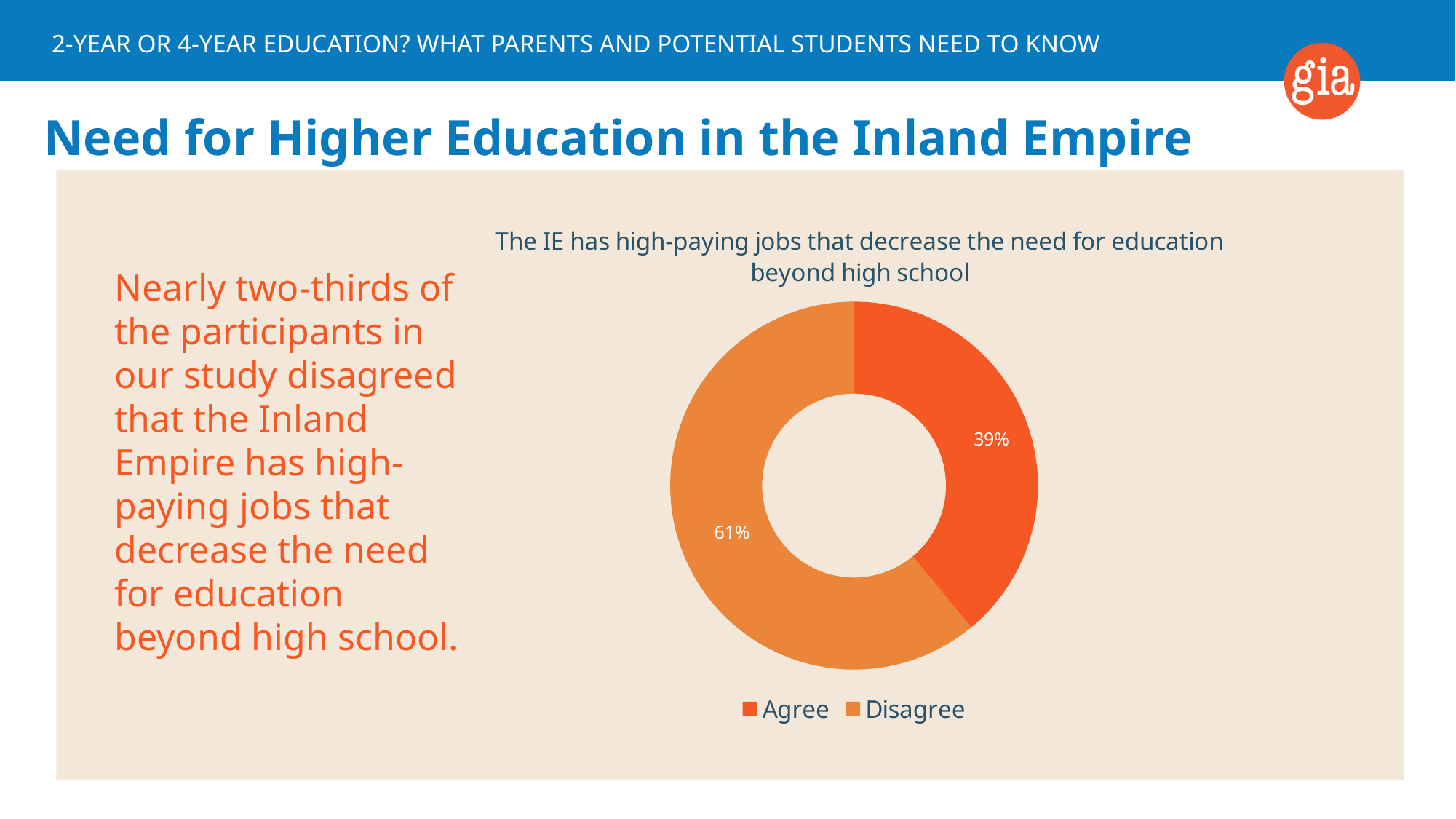
How many categories does the chart show? 2 What percentage of participants disagree that the IE has high-paying jobs that decrease the need for education beyond high school? 61% What is the difference in percentage points between the Disagree and Agree shares? 22 How many entries does the legend list? 2 What share of the pie does the Disagree slice represent? 61% Which legend entry is shown in the darker red-orange colour? Agree What percentage of participants agree that the IE has high-paying jobs that decrease the need for education beyond high school? 39% What kind of chart is shown on the slide? Pie chart (doughnut) What is the title of the chart? The IE has high-paying jobs that decrease the need for education beyond high school Which response has the larger share of the chart, Agree or Disagree? Disagree Which response has the smaller share of the chart? Agree Is the Agree share larger or smaller than the Disagree share? smaller